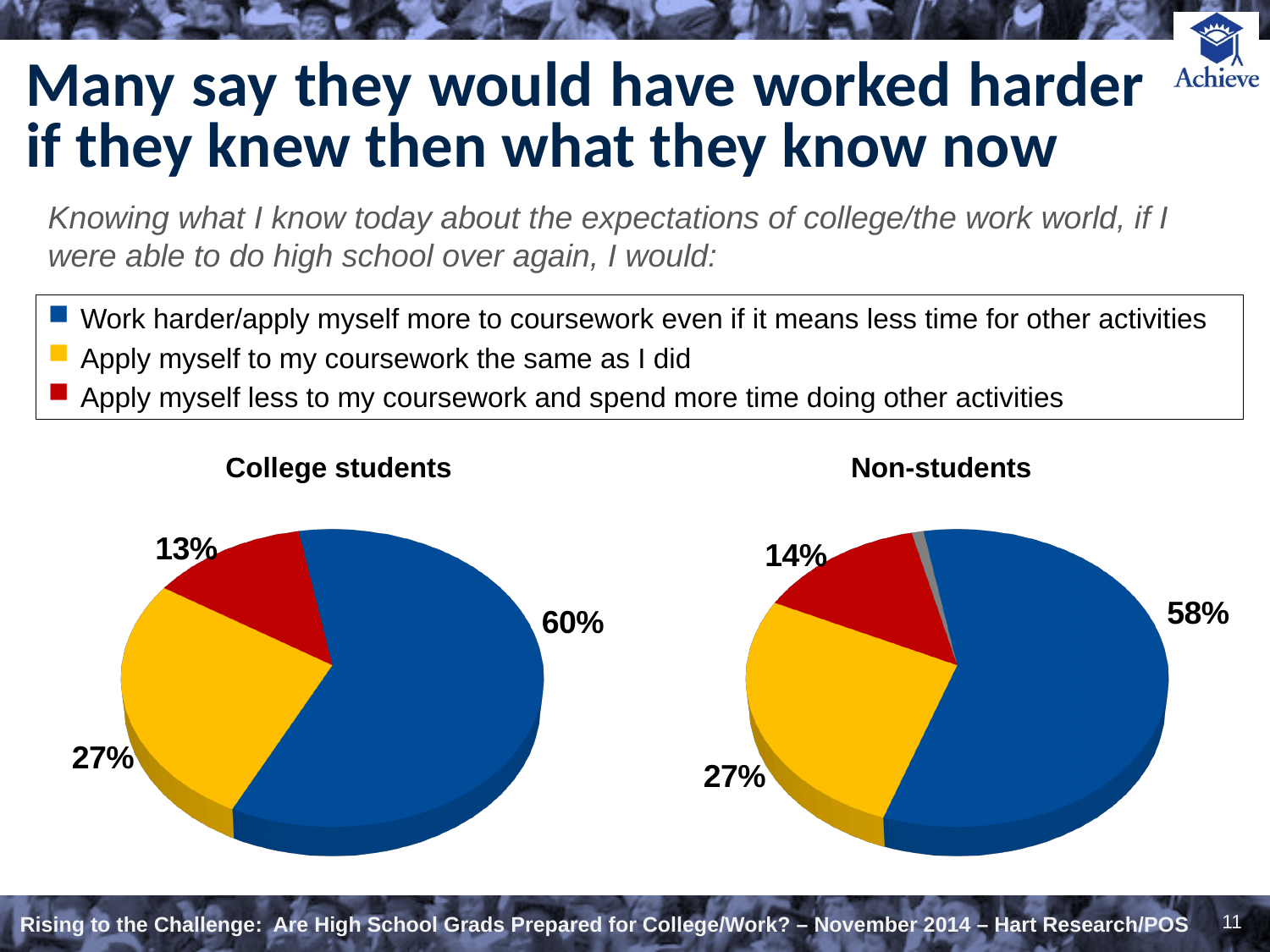
In the College students chart, which response has the largest share? Work harder/apply myself more to coursework What type of chart is used on this slide? Pie chart In the College students chart, what share said they would apply themselves to coursework the same as they did? 27% What is the difference between the 'work harder' share for College students and for Non-students? 2 percentage points In the College students chart, what share of respondents said they would work harder/apply themselves more to coursework? 60% In the Non-students chart, what share said they would apply themselves less to coursework? 14% How many response options does the legend list? 3 In the Non-students chart, what share of respondents said they would work harder/apply themselves more to coursework? 58% In the College students chart, what is the difference between the 'apply myself the same' share and the 'apply myself less' share? 14 percentage points In the College students chart, which response has the smallest share? Apply myself less to my coursework Which group has a larger share saying they would apply themselves less to coursework, College students or Non-students? Non-students Which colour represents 'Apply myself to my coursework the same as I did' in the charts? Yellow